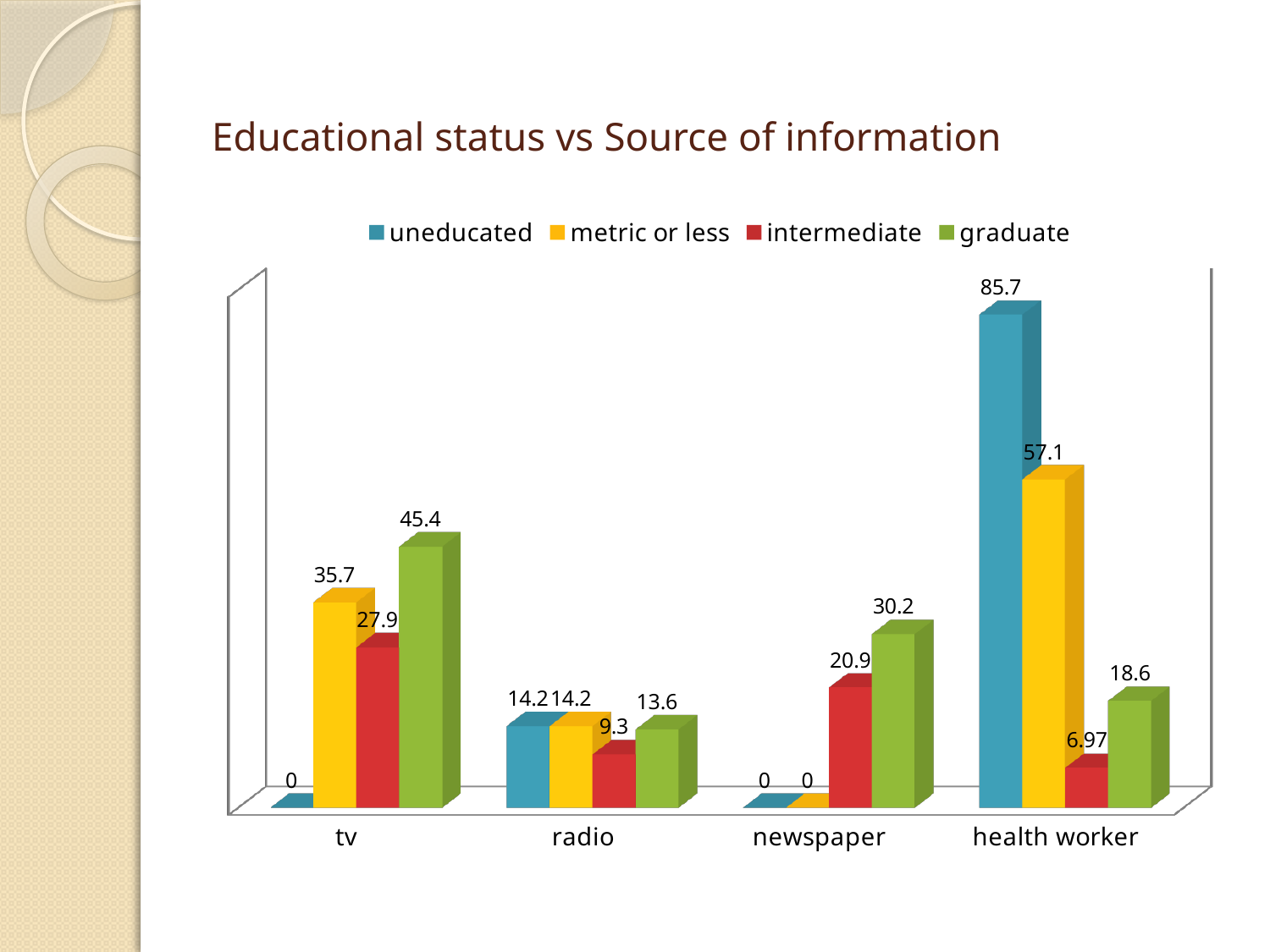
What is the value for intermediate in the health worker category? 6.97 What is the difference between the metric or less and intermediate values in the tv category? 7.8 What is the title of the chart? Educational status vs Source of information What kind of chart is shown on the slide? bar chart What is the value for uneducated in the health worker category? 85.7 Which is larger in the newspaper category: the intermediate value or the graduate value? graduate Which category has the lowest value for the graduate series? radio How many series does the legend list? 4 Which category has the highest value for the uneducated series? health worker What is the value for intermediate in the newspaper category? 20.9 What is the value for graduate in the tv category? 45.4 How many categories are shown on the x axis? 4